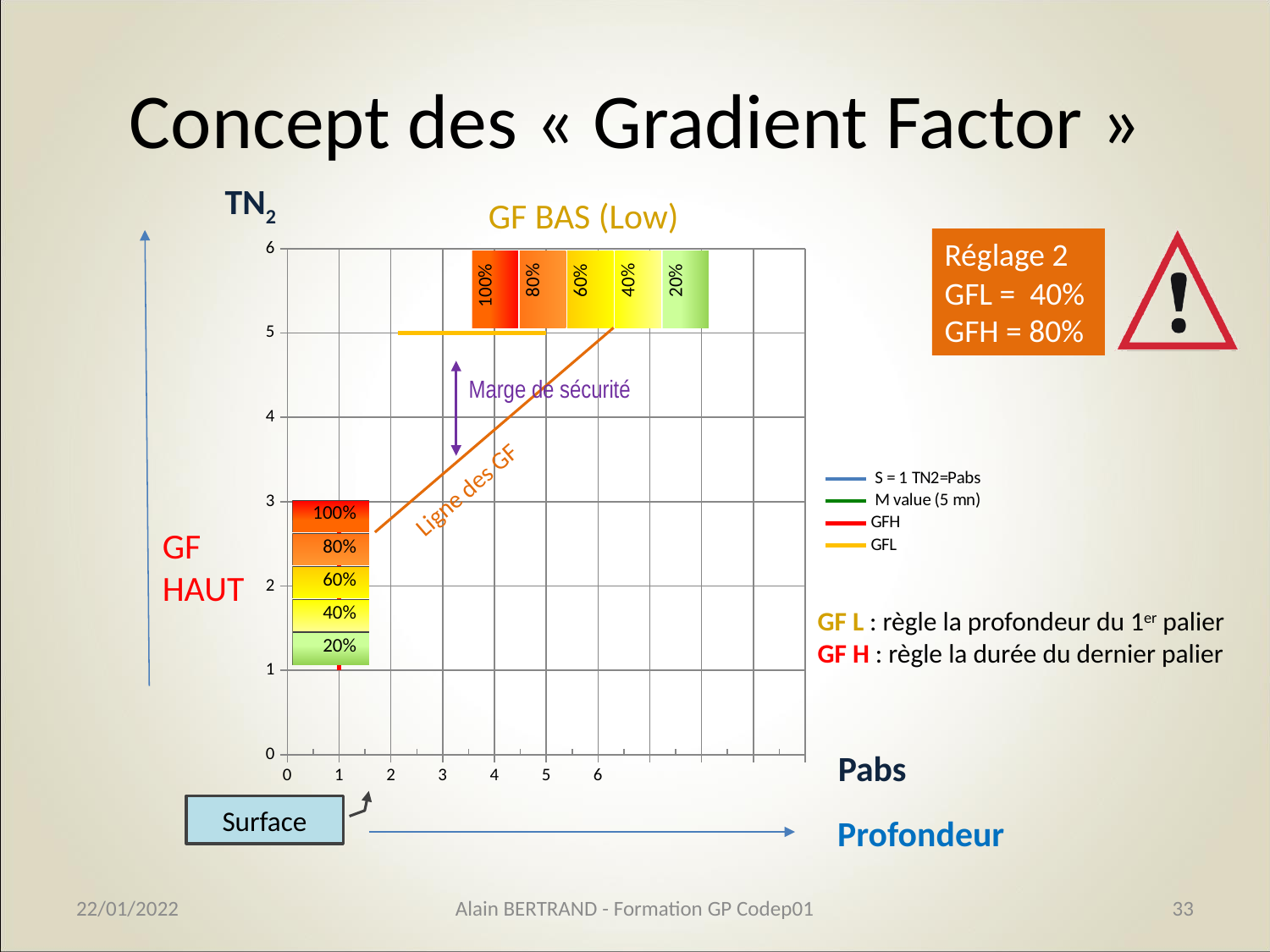
What kind of chart is shown on the slide? line chart How many percentage levels are shown on the horizontal GF BAS (Low) scale above the chart? 5 What colour is the GFL series in the chart legend? yellow What is the highest percentage shown on the GF BAS (Low) scale? 100% How many series does the chart legend list? 4 What is the highest labelled tick value on the horizontal axis of the chart? 6 What is the highest tick value on the vertical axis of the chart? 6 What is the lowest percentage shown on the GF HAUT scale? 20% How many percentage levels are shown on the vertical GF HAUT scale next to the chart? 5 What colour is the GFH series in the chart legend? red What is the first entry listed in the chart legend? S = 1 TN2=Pabs